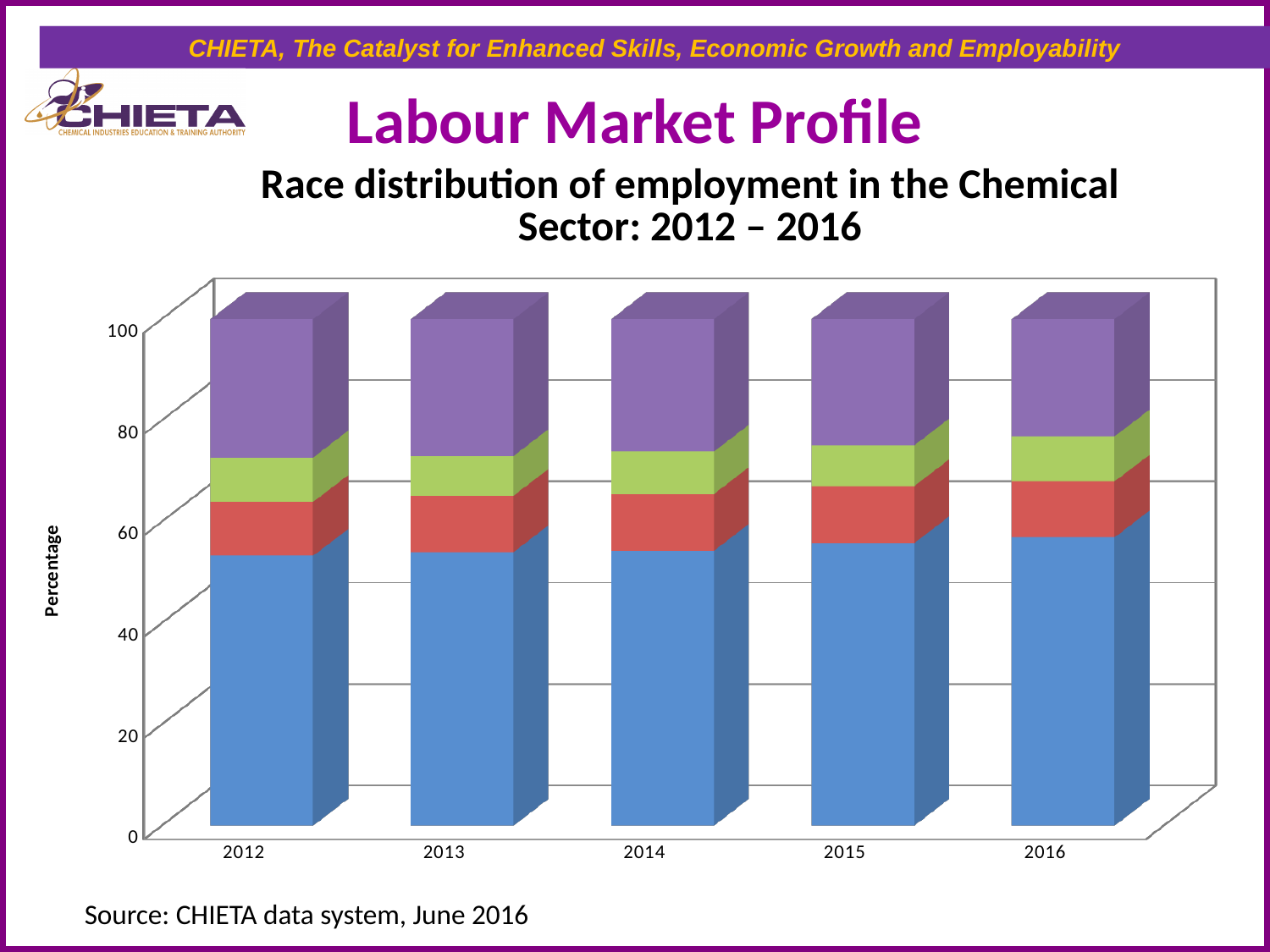
What is the label on the vertical axis of the chart? Percentage What is the total height of the 2012 stacked bar? 100 How many coloured segments make up each bar in the chart? 4 What kind of chart is shown on the slide? Stacked bar chart Does the blue (bottom) segment rise or fall from 2012 to 2016? rises Is the blue (bottom) segment of the 2012 bar greater or less than 40? greater What is the total height of the 2016 stacked bar? 100 Which year has the largest blue (bottom) segment? 2016 What is the title of the chart? Race distribution of employment in the Chemical Sector: 2012 – 2016 Is the blue (bottom) segment of the 2016 bar greater or less than 80? less How many years are shown on the x axis of the chart? 5 Is the blue (bottom) segment larger in 2012 or in 2016? 2016